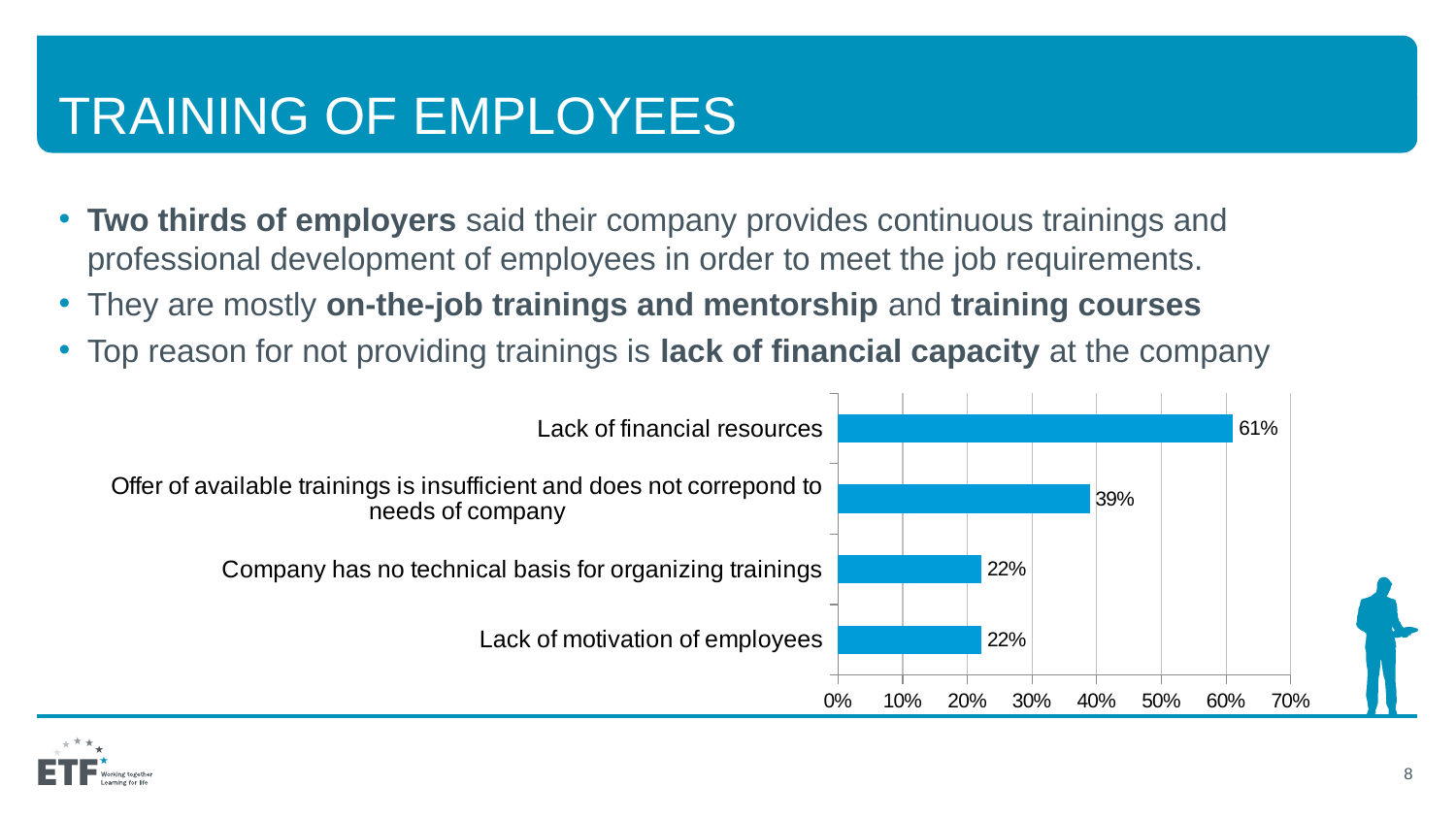
Is the value for Lack of financial resources greater or less than 50%? greater What is the value for Company has no technical basis for organizing trainings? 22% What is the maximum value shown on the horizontal axis of the chart? 70% What is the value for Offer of available trainings is insufficient and does not correpond to needs of company? 39% Which is larger: the value for Lack of financial resources or the value for Company has no technical basis for organizing trainings? Lack of financial resources How many categories are shown in the chart? 4 What kind of chart is shown on the slide? bar chart What is the difference between the values for Lack of financial resources and Offer of available trainings is insufficient and does not correpond to needs of company? 22% What is the difference between the values for Offer of available trainings is insufficient and does not correpond to needs of company and Lack of motivation of employees? 17% What is the value for Lack of financial resources? 61% What is the value for Lack of motivation of employees? 22% Which category has the highest value? Lack of financial resources